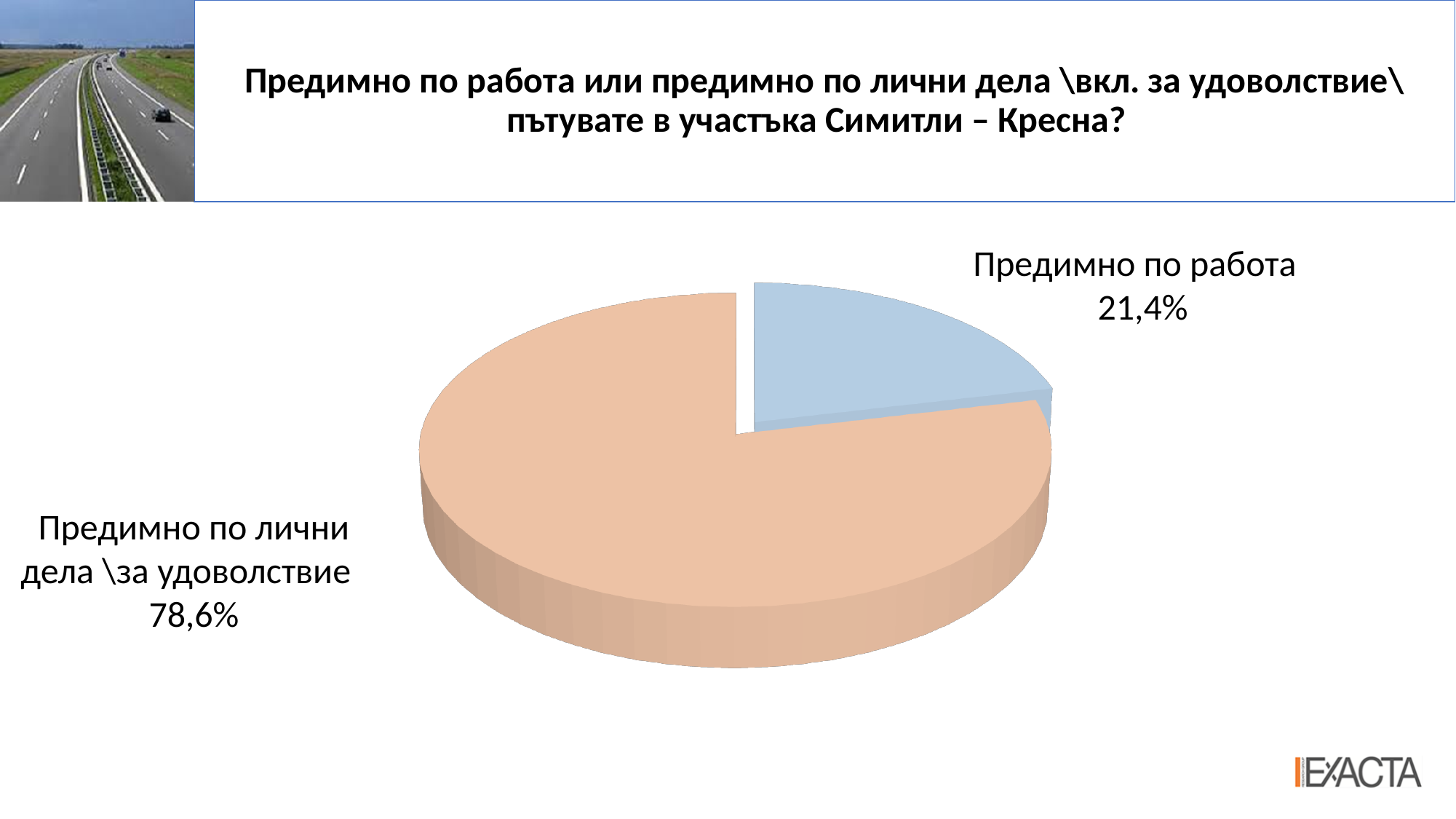
What is the value for "Предимно по лични дела \за удоволствие"? 78,6% What is the value for "Предимно по работа"? 21,4% What is the title of the chart on the slide? Предимно по работа или предимно по лични дела \вкл. за удоволствие\ пътувате в участъка Симитли – Кресна? Which is larger: the share for "Предимно по работа" or the share for "Предимно по лични дела \за удоволствие"? Предимно по лични дела \за удоволствие What kind of chart is shown on the slide? Pie chart Which category has the smallest share of the pie? Предимно по работа What colour is the slice for "Предимно по работа"? Light blue What is the difference between the share for "Предимно по лични дела \за удоволствие" and the share for "Предимно по работа"? 57,2% What share of the pie does the "Предимно по работа" slice represent? 21,4% Which category has the largest share of the pie? Предимно по лични дела \за удоволствие How many slices does the pie chart have? 2